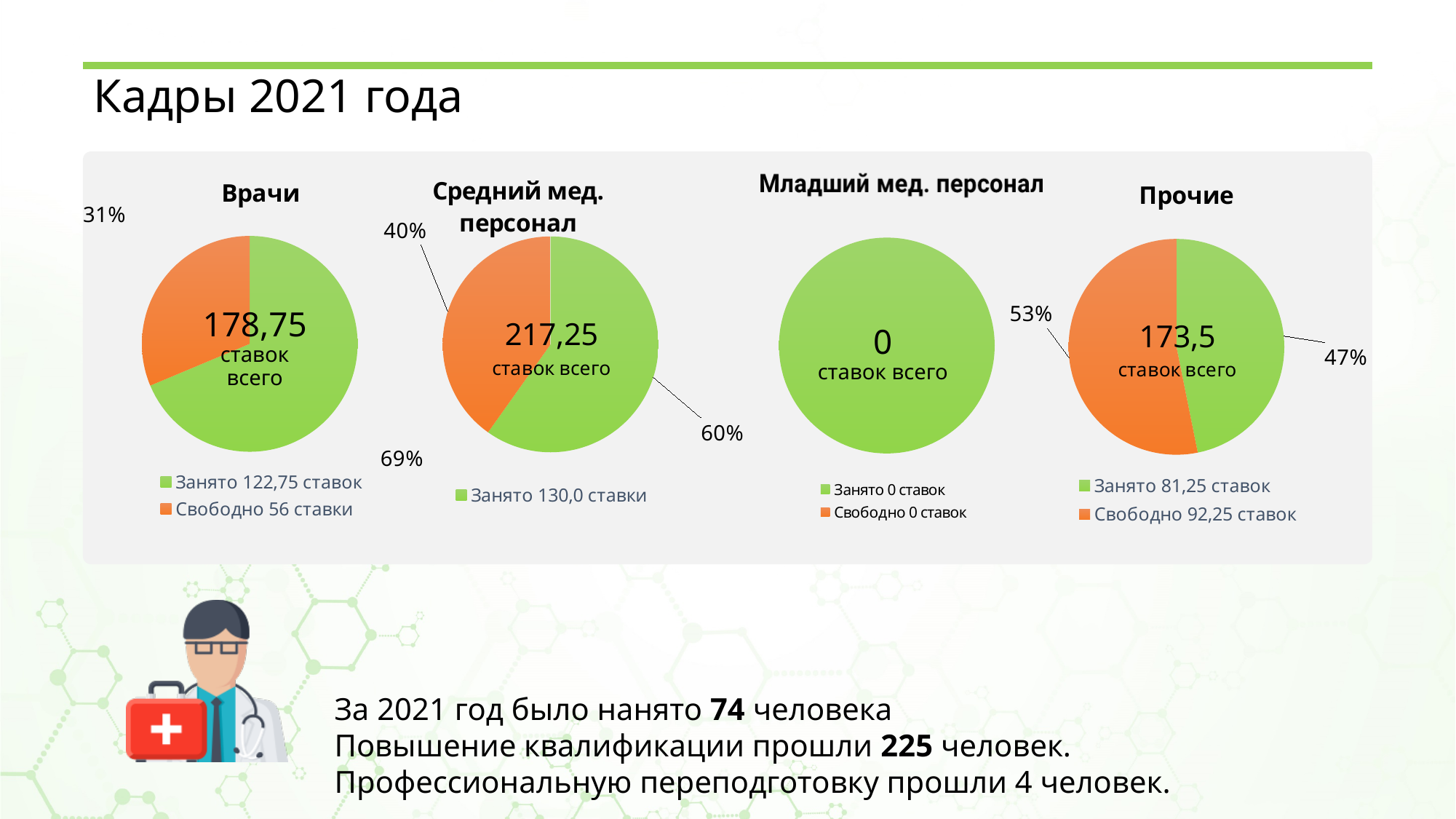
In the 'Врачи' chart, what share of positions is free (the orange slice)? 31% In the 'Прочие' chart, which is larger: the occupied (Занято) or the free (Свободно) slice? Свободно What kind of charts are shown on the slide? Pie charts In the 'Средний мед. персонал' chart, what is the total number of positions? 217,25 In the 'Прочие' chart, how many positions are free (Свободно)? 92,25 ставок In the 'Врачи' chart, what is the total number of positions (ставок всего)? 178,75 In the 'Средний мед. персонал' chart, what share of positions is occupied (the green slice)? 60% How many pie charts are on the slide? 4 Which of the four charts has the largest total number of positions? Средний мед. персонал In the 'Врачи' chart, how many positions are free (Свободно)? 56 ставки In the 'Врачи' chart, how many positions are occupied (Занято)? 122,75 ставок In the 'Младший мед. персонал' chart, what is the total number of positions? 0